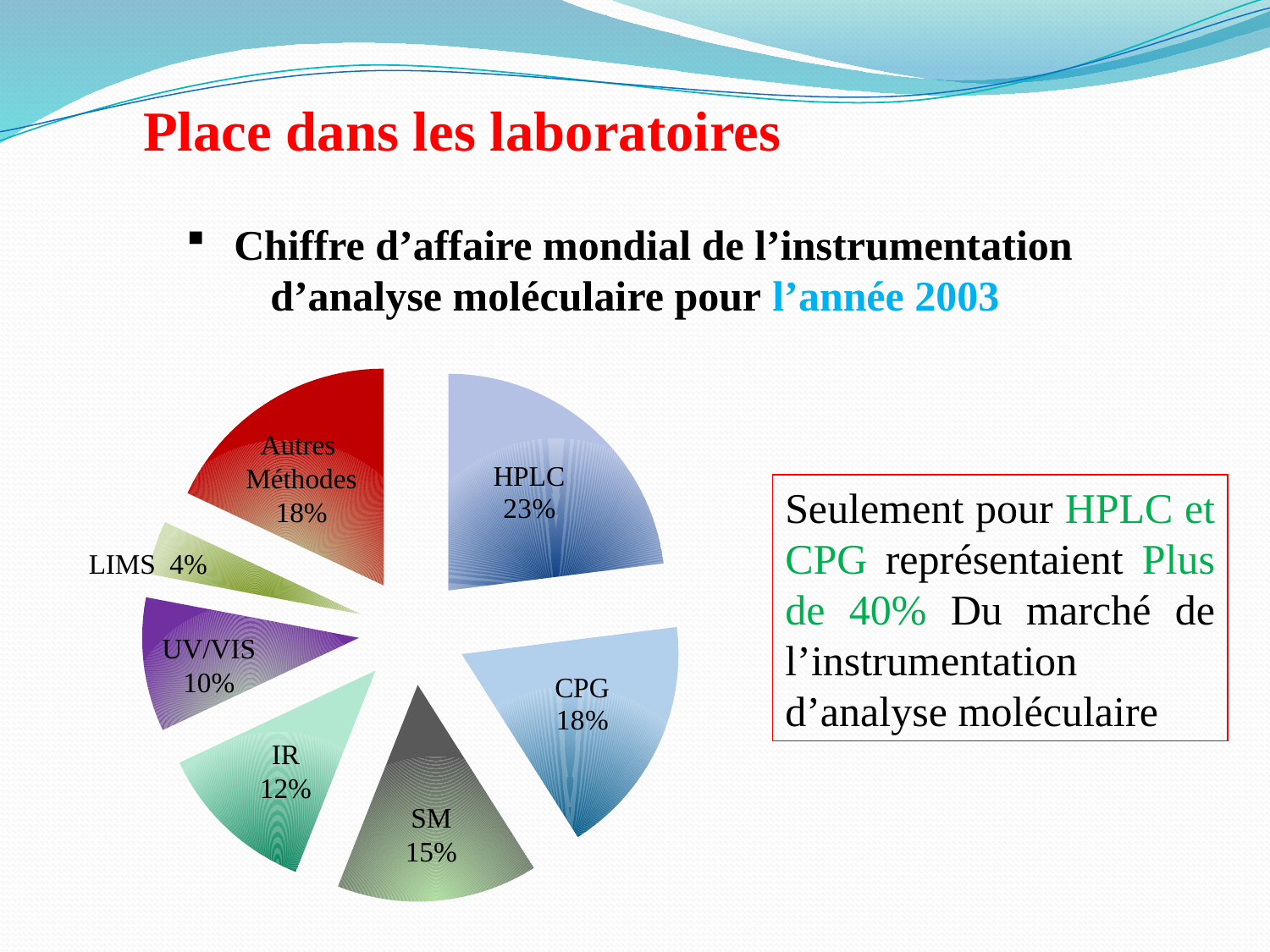
Which category has the largest slice of the pie? HPLC What colour is the slice labelled Autres Méthodes? red Which is larger, the share for IR or the share for SM? SM What percentage is shown for SM? 15% What kind of chart is shown on the slide? pie chart What is the value shown for CPG? 18% Which category has the smallest slice of the pie? LIMS How many slices does the pie chart have? 7 What is the combined share of HPLC and CPG? 41% What is the value for UV/VIS? 10% What share of the pie does HPLC represent? 23% What is the difference between the HPLC share and the CPG share? 5%